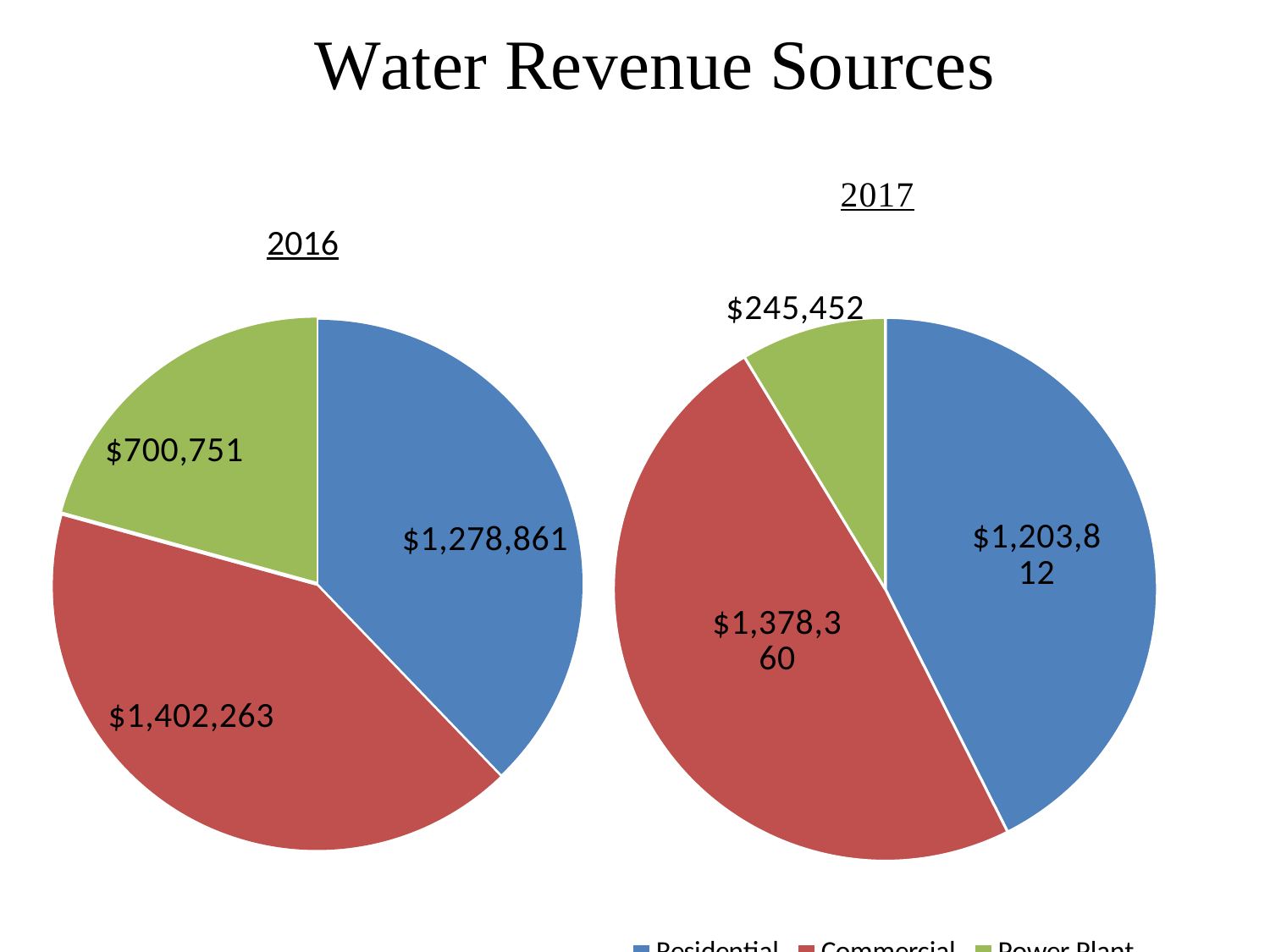
In the 2017 pie chart, what is the value for Power Plant? $245,452 How many slices does the 2017 pie chart have? 3 What is the difference between the Power Plant value in the 2016 pie chart and the Power Plant value in the 2017 pie chart? $455,299 Is the Residential value larger in the 2016 pie chart or the 2017 pie chart? 2016 In the 2016 pie chart, what is the value for Commercial? $1,402,263 In the 2017 pie chart, what is the difference between the Commercial and Residential values? $174,548 In the 2017 pie chart, which revenue source has the smallest value? Power Plant In the 2017 pie chart, what is the value for Residential? $1,203,812 What is the title of the slide containing the two pie charts? Water Revenue Sources In the 2016 pie chart, which revenue source has the largest value? Commercial What kind of chart is used to show the 2016 water revenue sources? Pie chart In the 2016 pie chart, what is the value for Power Plant? $700,751